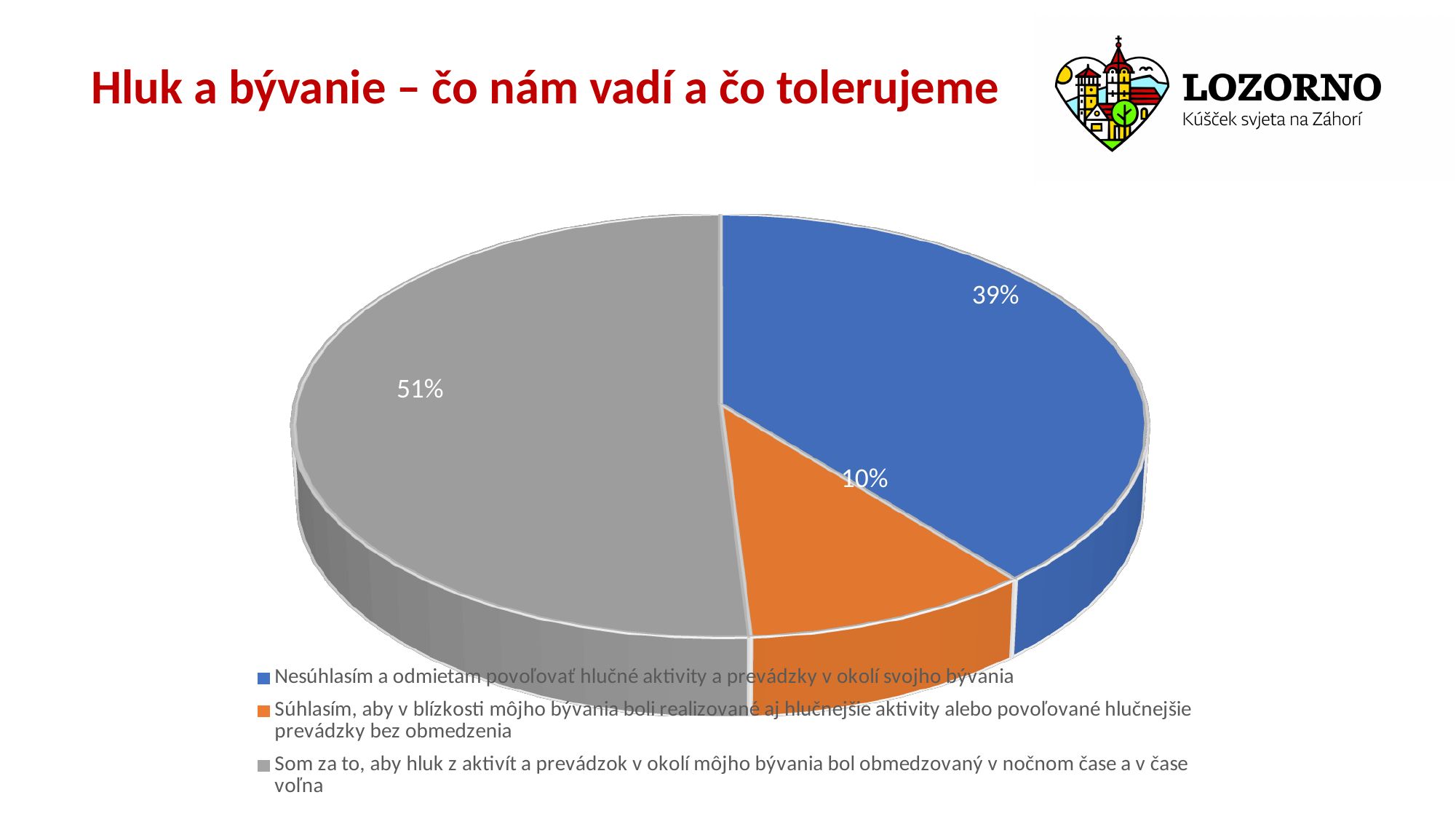
What colour is the slice labelled 51%? grey What share of the pie is labelled for the slice 'Súhlasím, aby v blízkosti môjho bývania boli realizované aj hlučnejšie aktivity alebo povoľované hlučnejšie prevádzky bez obmedzenia'? 10% Which slice of the pie is the smallest? Súhlasím, aby v blízkosti môjho bývania boli realizované aj hlučnejšie aktivity alebo povoľované hlučnejšie prevádzky bez obmedzenia How many slices does the pie chart have? 3 What share of the pie is labelled for the slice 'Nesúhlasím a odmietam povoľovať hlučné aktivity a prevádzky v okolí svojho bývania'? 39% Which is larger: the 'Nesúhlasím a odmietam...' slice or the 'Súhlasím, aby v blízkosti...' slice? Nesúhlasím a odmietam povoľovať hlučné aktivity a prevádzky v okolí svojho bývania What kind of chart is shown on the slide? pie chart What is the title of the slide containing the chart? Hluk a bývanie – čo nám vadí a čo tolerujeme How many entries does the legend list? 3 What share of the pie is labelled for the slice 'Som za to, aby hluk z aktivít a prevádzok v okolí môjho bývania bol obmedzovaný v nočnom čase a v čase voľna'? 51% Which slice of the pie is the largest? Som za to, aby hluk z aktivít a prevádzok v okolí môjho bývania bol obmedzovaný v nočnom čase a v čase voľna What is the difference in percentage points between the largest slice (51%) and the 'Nesúhlasím a odmietam...' slice (39%)? 12